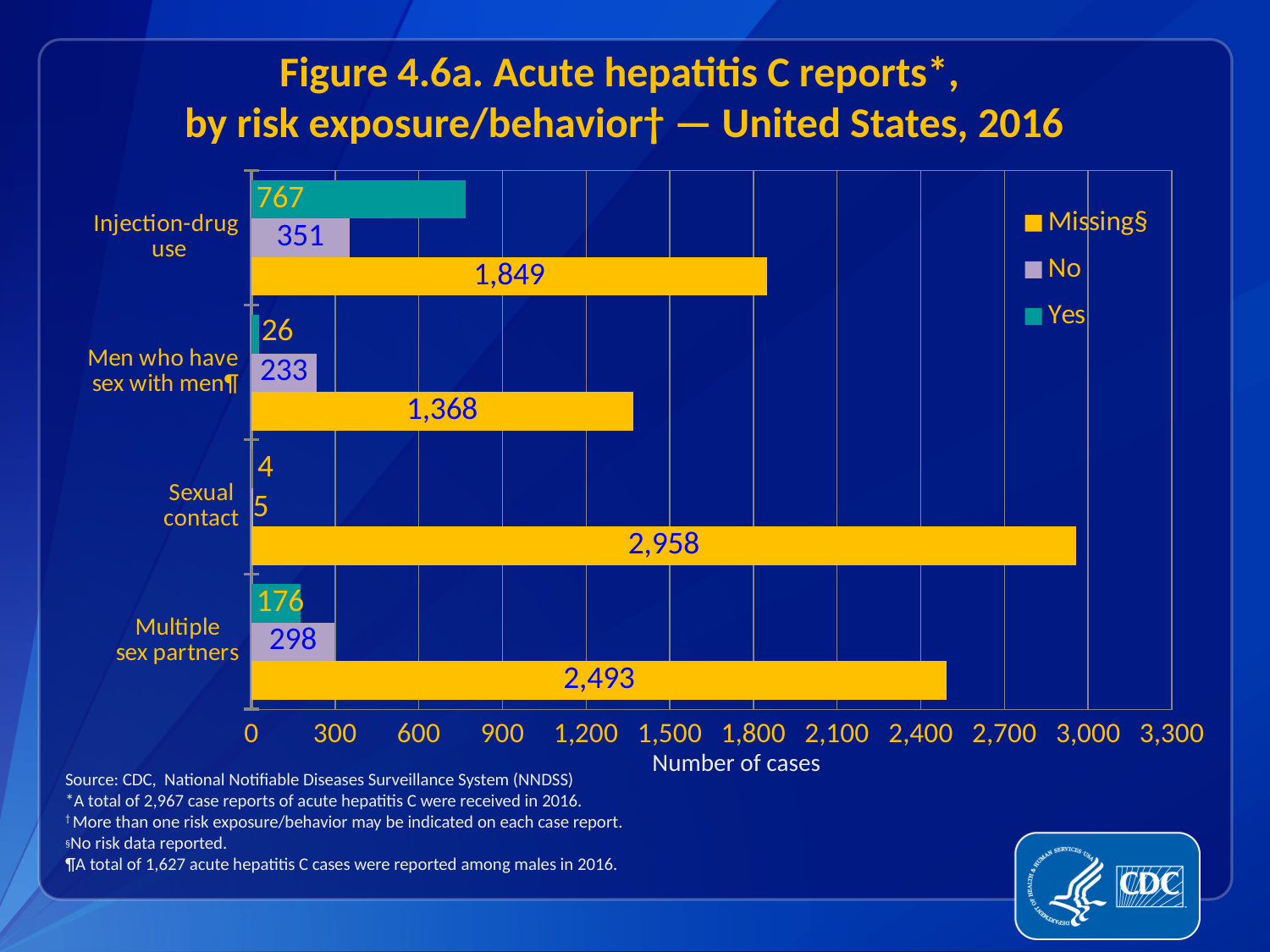
How many series does the legend list? 3 Which category has the highest 'Missing' value? Sexual contact Which is larger for Men who have sex with men: the 'Yes' value or the 'No' value? No How many risk exposure/behavior categories are shown on the chart? 4 What is the number of cases with 'Yes' for Injection-drug use? 767 Which category has the lowest 'Yes' value? Sexual contact What is the label of the x axis? Number of cases What is the difference between the 'Missing' values for Multiple sex partners and Injection-drug use? 644 What is the number of cases with 'Missing' for Sexual contact? 2,958 What type of chart is shown on the slide? Bar chart What colour represents the 'Missing§' series in the legend? Yellow What is the number of cases with 'No' for Multiple sex partners? 298